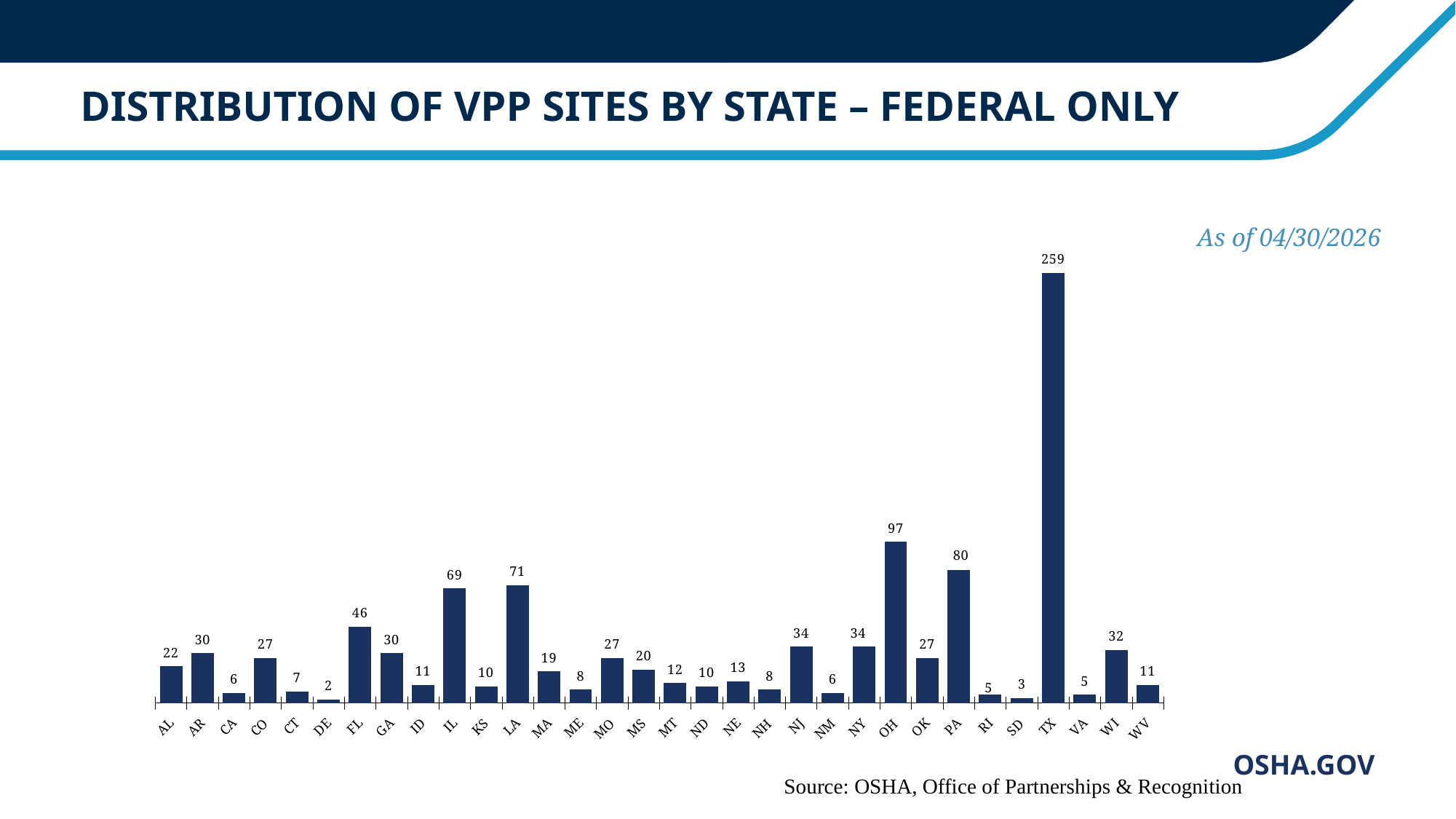
Which state has the lowest number of VPP sites? DE Which has a larger value, FL or WI? FL What is the number of VPP sites for OH? 97 Which has a larger value, PA or OH? OH What is the number of VPP sites for TX? 259 What is the difference between the values for TX and OH? 162 What kind of chart is shown on the slide? Bar chart What is the difference between the values for LA and IL? 2 What is the number of VPP sites for FL? 46 What date is the data on the chart current as of? 04/30/2026 How many states are shown on the x axis? 32 Which state has the highest number of VPP sites? TX